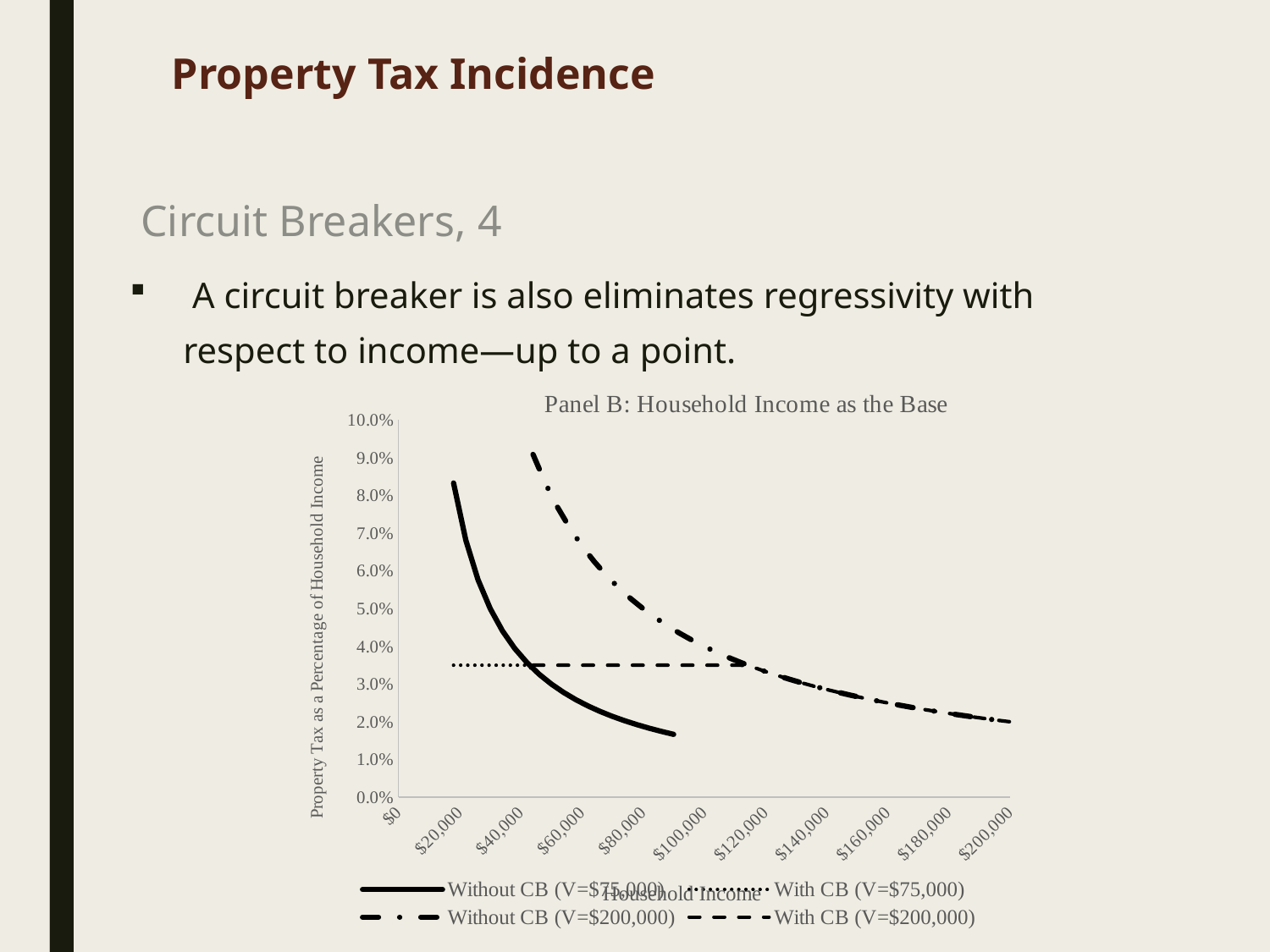
Does the 'Without CB (V=$200,000)' line rise or fall as household income increases? fall Is the value of the 'Without CB (V=$75,000)' line at $20,000 household income greater or less than 7.0%? greater Is the flat portion of the 'With CB (V=$200,000)' line greater or less than 4.0%? less What is the label of the vertical axis of the chart? Property Tax as a Percentage of Household Income Is the value of the 'Without CB (V=$75,000)' line at $40,000 household income greater or less than 5.0%? less What kind of chart is shown on the slide? line chart What is the title of the chart? Panel B: Household Income as the Base How many series does the chart's legend list? 4 Does the 'Without CB (V=$75,000)' line rise or fall as household income increases? fall At $60,000 household income, which line is higher: 'Without CB (V=$200,000)' or 'Without CB (V=$75,000)'? Without CB (V=$200,000)